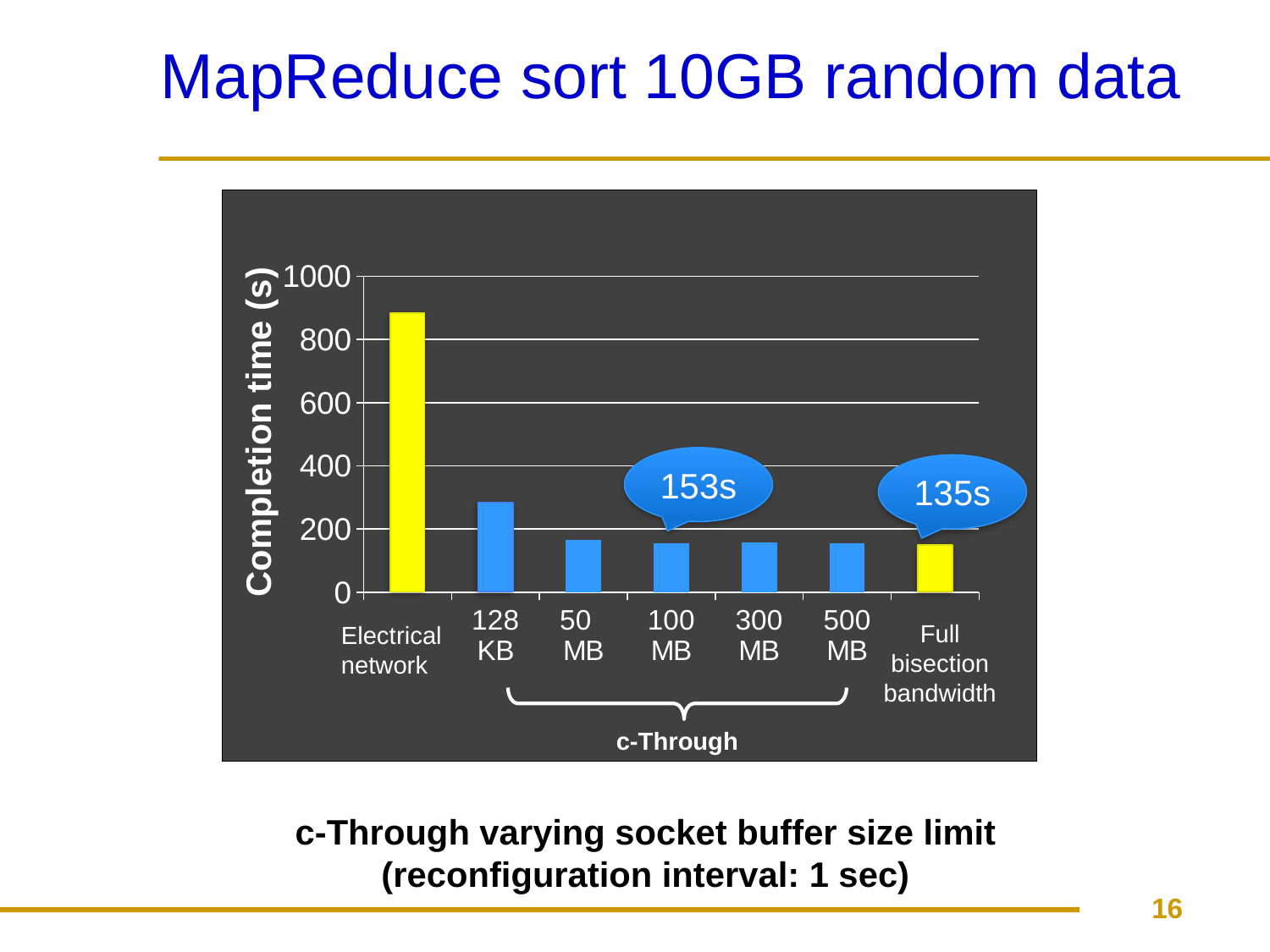
Which has a larger completion time, Electrical network or 128 KB? Electrical network What is the completion time for Full bisection bandwidth? 135s What is the difference in completion time between the 100 MB c-Through configuration and Full bisection bandwidth? 18s How many categories are shown on the x axis? 7 What is the completion time for the 100 MB socket buffer size? 153s What kind of chart is shown on the slide? Bar chart What is the label of the y axis? Completion time (s) Which category has the highest completion time? Electrical network Is the completion time for Electrical network greater or less than 800? greater Is the completion time for 128 KB greater or less than 200? greater Which category has the lowest completion time? Full bisection bandwidth Is the completion time for 50 MB greater or less than 200? less